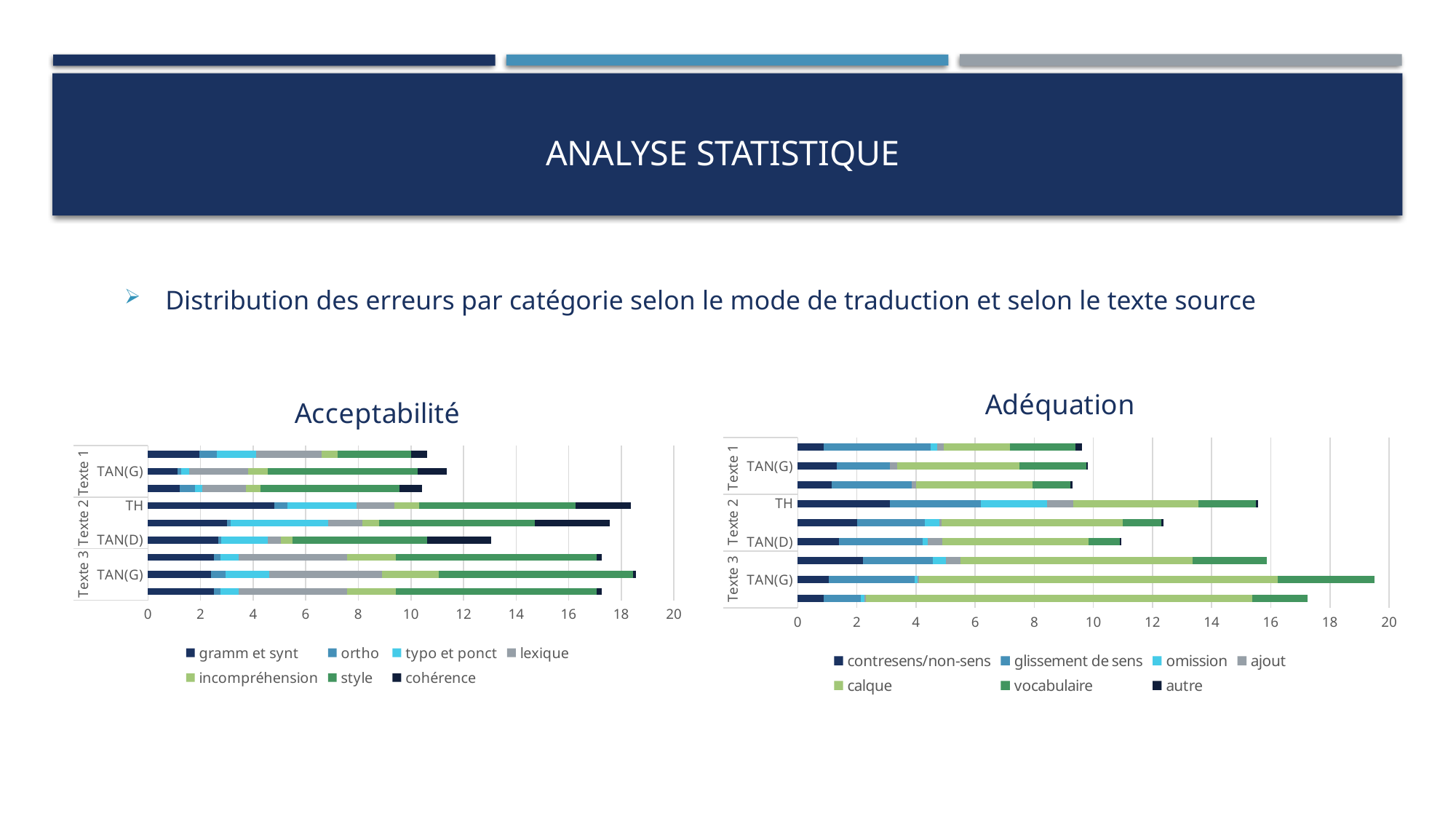
In the Acceptabilité chart, which bar is longer in total: the TH bar for Texte 2 or the TAN(G) bar for Texte 1? TH bar for Texte 2 How many series does the legend of the Acceptabilité chart list? 7 What is the maximum value shown on the x axis of the Acceptabilité chart? 20 What is the title of the chart on the right side of the slide? Adéquation What kind of chart is the Acceptabilité chart? Stacked bar chart How many series does the legend of the Adéquation chart list? 7 In the Acceptabilité chart, is the total length of the TH bar for Texte 2 greater or less than 16? greater How many bars are plotted in the Adéquation chart? 9 In the Adéquation chart, is the total length of the TAN(G) bar for Texte 1 greater or less than 10? less In the Acceptabilité chart, is the total length of the TAN(G) bar for Texte 1 greater or less than 12? less In the Adéquation chart, which text group contains the longest bar? Texte 3